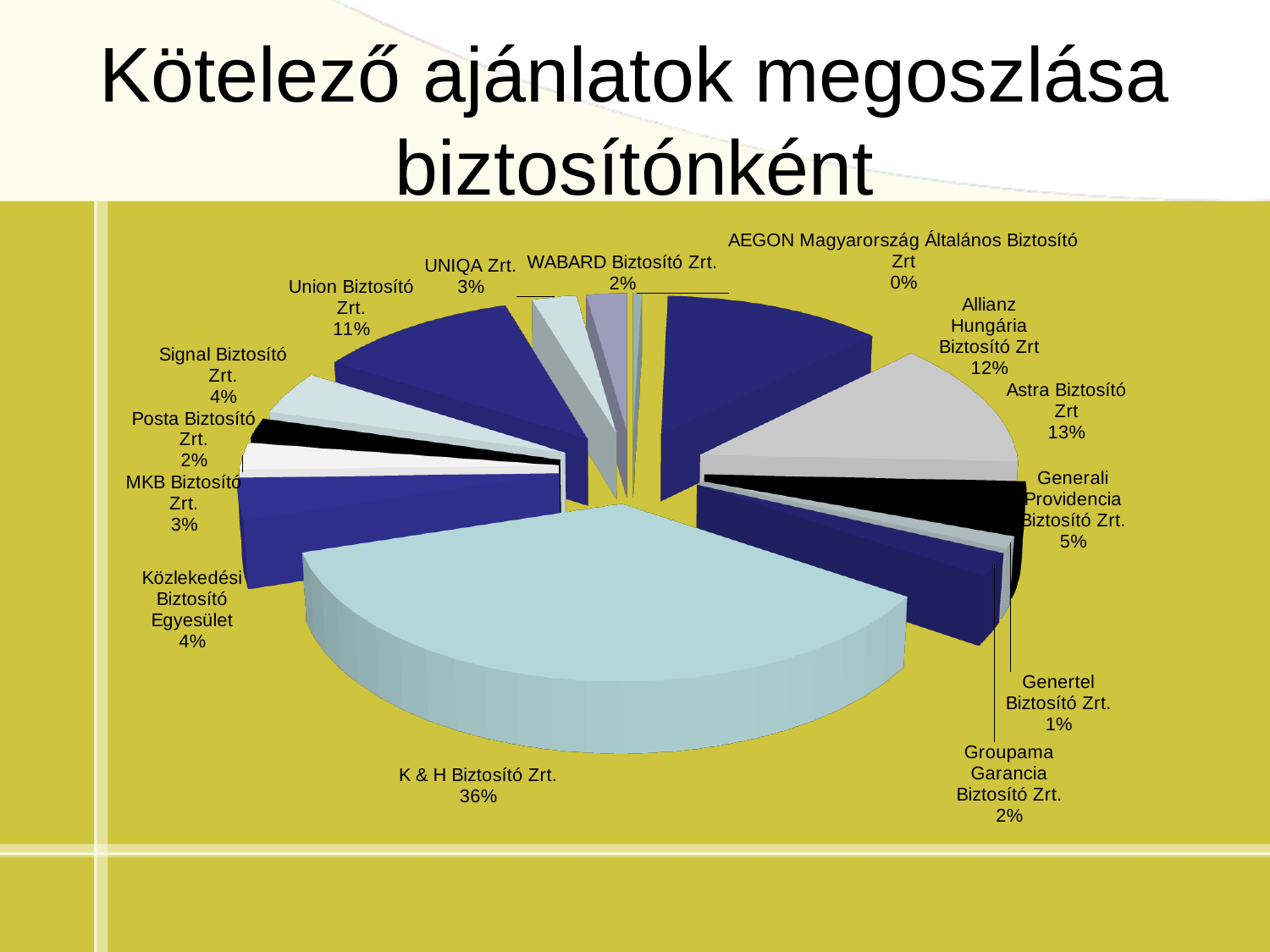
What share of the pie does K & H Biztosító Zrt. hold? 36% What percentage is shown for Generali Providencia Biztosító Zrt.? 5% How many insurers (slices) are labelled on the pie chart? 14 What percentage is shown for Genertel Biztosító Zrt.? 1% What is the title of the slide containing the chart? Kötelező ajánlatok megoszlása biztosítónként What percentage is shown for Union Biztosító Zrt.? 11% Which insurer has the smallest share, shown as 0%? AEGON Magyarország Általános Biztosító Zrt What percentage is shown for Astra Biztosító Zrt? 13% What is the difference in percentage points between Astra Biztosító Zrt and Allianz Hungária Biztosító Zrt? 1% What type of chart is shown on the slide? Pie chart Which insurer has the largest slice of the pie? K & H Biztosító Zrt. Which has a larger share, Union Biztosító Zrt. or Allianz Hungária Biztosító Zrt? Allianz Hungária Biztosító Zrt